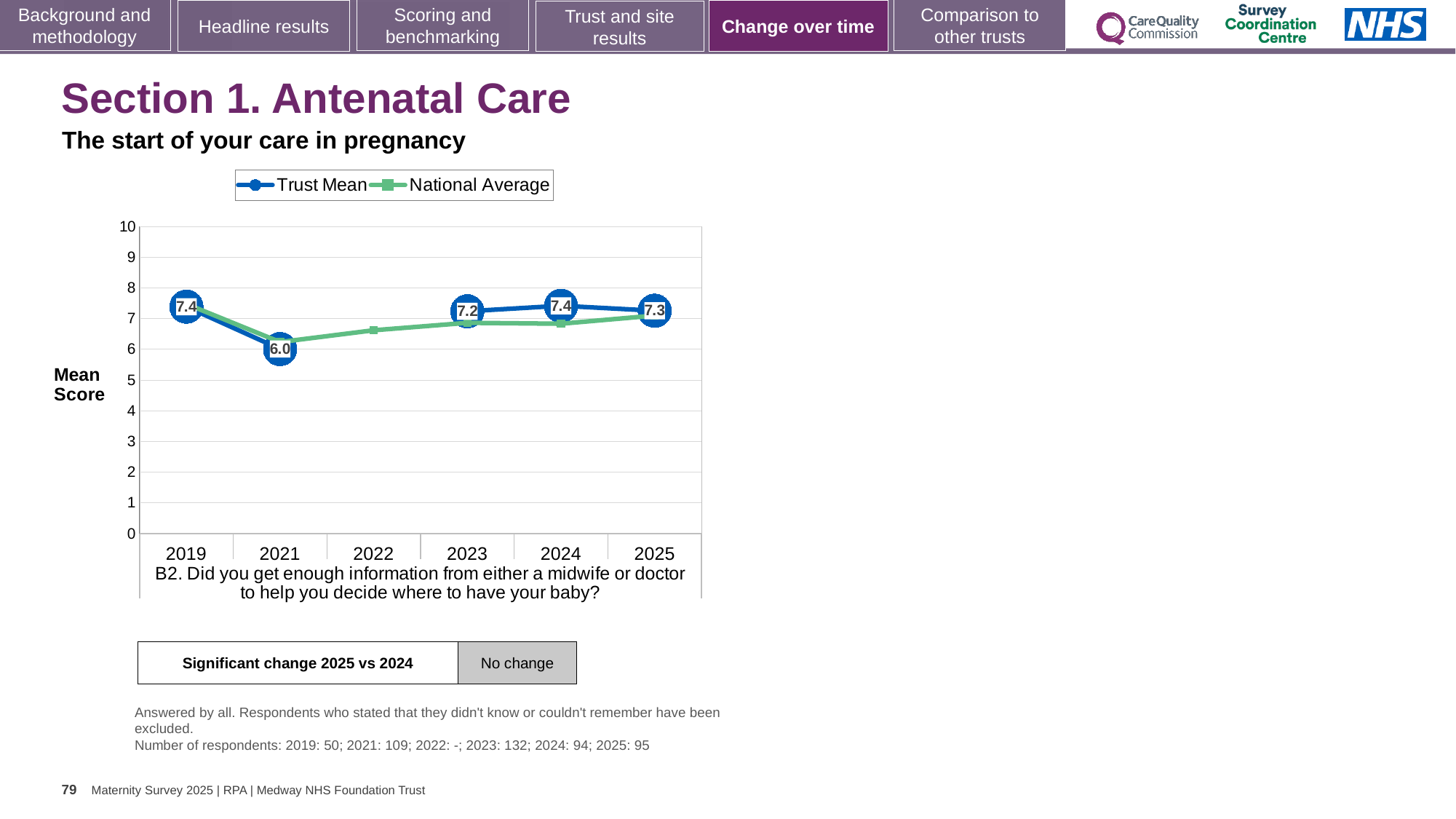
How many years are shown on the x axis? 6 What is the Trust Mean for 2023? 7.2 Does the Trust Mean rise or fall from 2021 to 2024? rise What is the Trust Mean for 2019? 7.4 What is the Trust Mean for 2021? 6.0 How many series does the legend list? 2 Is the National Average value for 2022 greater or less than 7? less Which is larger, the Trust Mean for 2023 or for 2021? 2023 What is the difference between the Trust Mean in 2024 and in 2021? 1.4 What is the Trust Mean for 2025? 7.3 In which year is the Trust Mean lowest? 2021 What kind of chart is shown? line chart